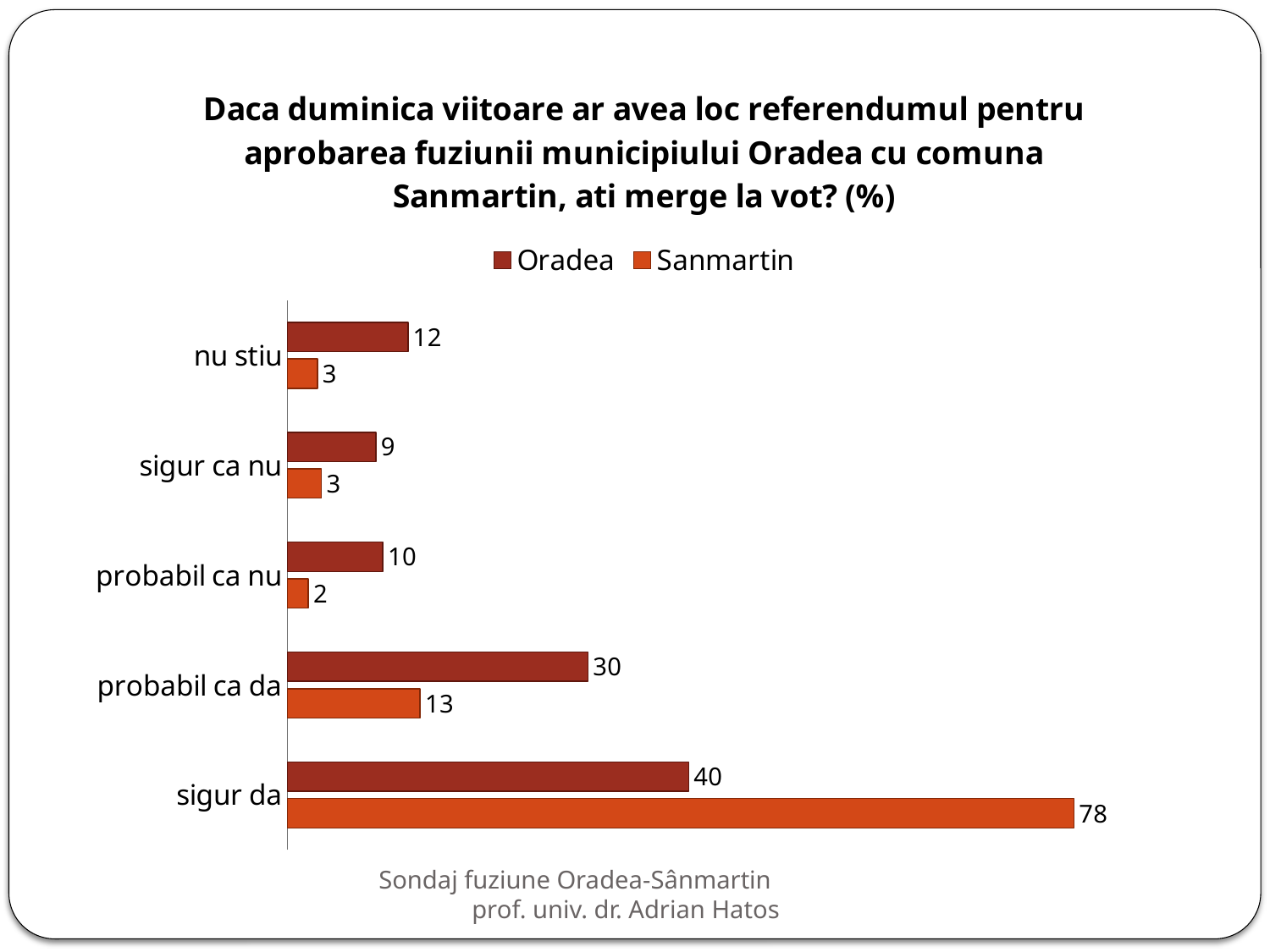
What is the value for Oradea in the 'probabil ca da' category? 30 Which is larger in the 'sigur ca nu' category, the Oradea value or the Sanmartin value? Oradea What is the difference between the Oradea and Sanmartin values in the 'probabil ca da' category? 17 What is the value for Oradea in the 'nu stiu' category? 12 What is the value for Sanmartin in the 'probabil ca nu' category? 2 How many categories are shown on the chart? 5 Which category has the highest value for the Oradea series? sigur da What kind of chart is shown on the slide? bar chart How many series does the legend list? 2 What is the value for Sanmartin in the 'sigur da' category? 78 What is the difference between the Sanmartin and Oradea values in the 'sigur da' category? 38 Which category has the lowest value for the Sanmartin series? probabil ca nu